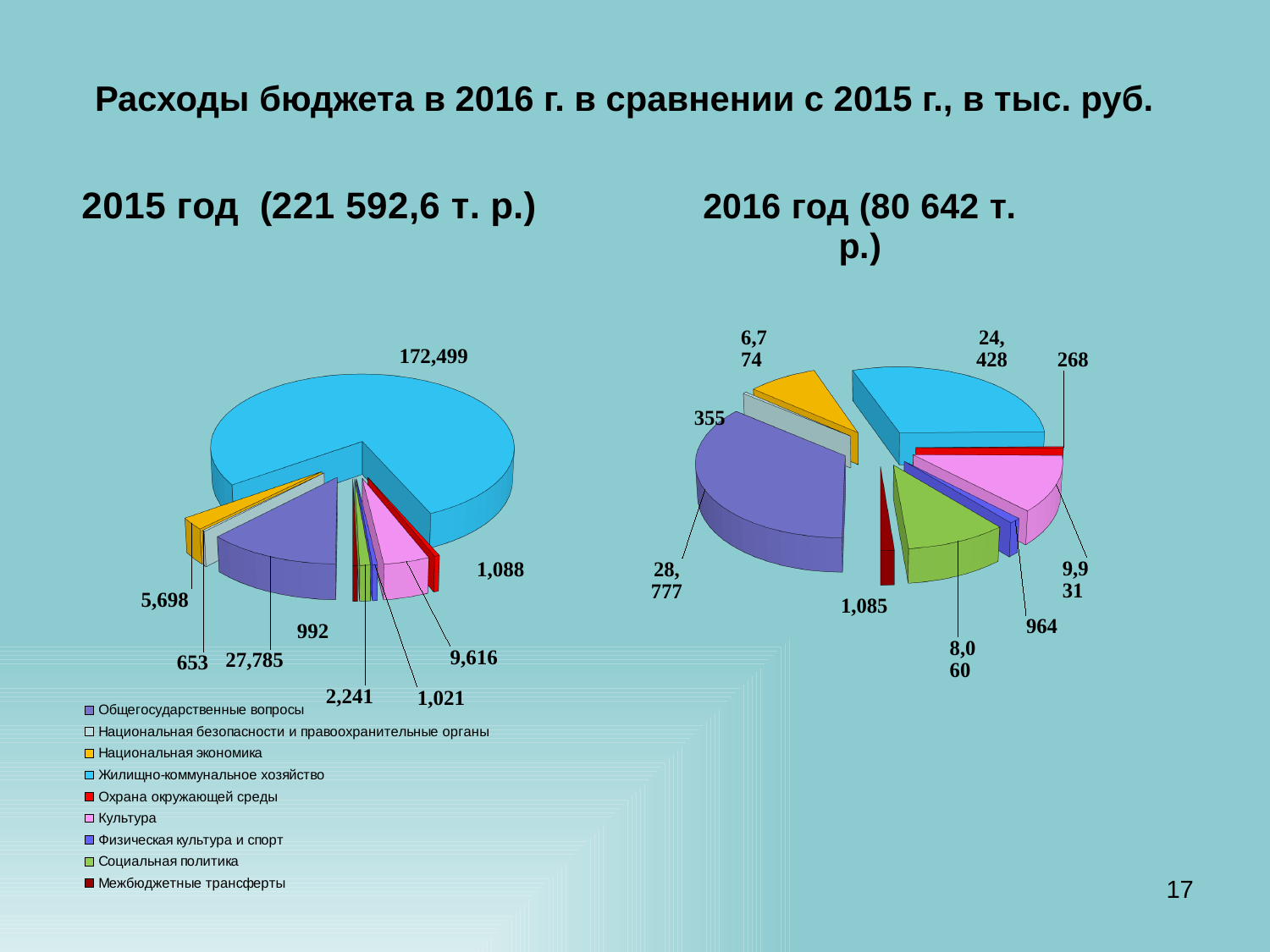
What total budget expenditure is shown in the heading for 2016 год? 80 642 т. р. In the 2016 год chart, what is the value for Охрана окружающей среды? 268 In the 2016 год chart, which category has the largest slice? Общегосударственные вопросы In the 2015 год chart, which category has the largest slice? Жилищно-коммунальное хозяйство In the 2015 год chart, which category has the smallest slice? Национальная безопасности и правоохранительные органы Which is larger: Культура in the 2015 год chart or Культура in the 2016 год chart? 2016 год (9,931) In the 2016 год chart, what is the value for Общегосударственные вопросы? 28,777 What kind of chart is used for the 2015 год budget expenditures? Pie chart How many categories does the legend list for the budget expenditure charts? 9 In the 2016 год chart, what is the value for Жилищно-коммунальное хозяйство? 24,428 In the 2015 год chart, what is the value for Общегосударственные вопросы? 27,785 In the 2015 год chart, what is the value for Жилищно-коммунальное хозяйство? 172,499